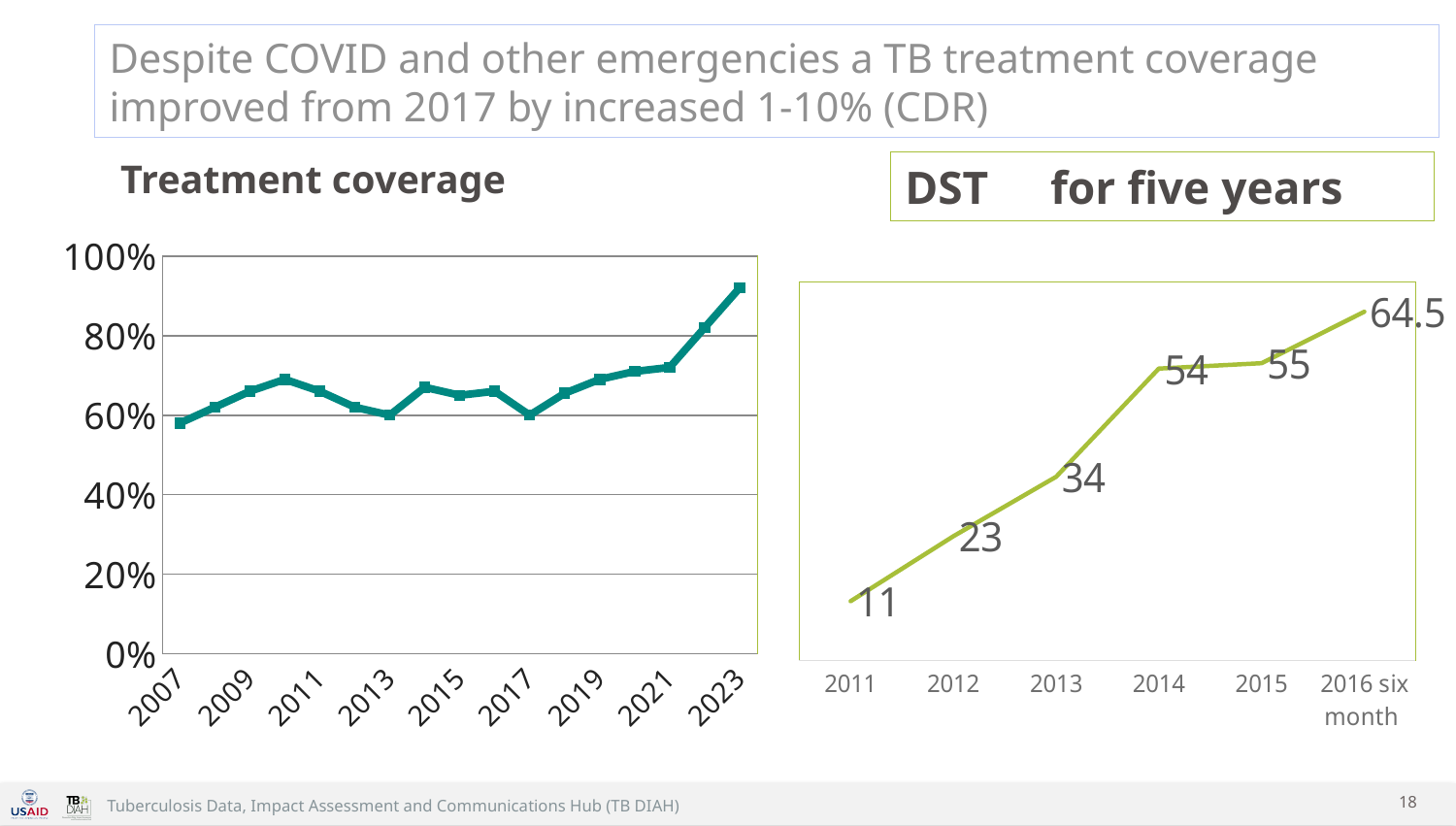
What kind of chart is the Treatment coverage chart? line chart In the DST for five years chart, how many data points are plotted? 6 In the Treatment coverage chart, is the value for 2023 greater or less than 80%? greater In the DST for five years chart, which point has the highest value? 2016 six month In the DST for five years chart, what is the value for 2016 six month? 64.5 In the DST for five years chart, do the values rise or fall from 2011 to 2016 six month? rise In the DST for five years chart, which year has the lowest value? 2011 In the DST for five years chart, what is the value for 2011? 11 In the DST for five years chart, what is the difference between the values for 2014 and 2012? 31 In the DST for five years chart, what is the value for 2013? 34 In the DST for five years chart, what is the difference between the values for 2015 and 2014? 1 In the Treatment coverage chart, which year has the highest treatment coverage? 2023